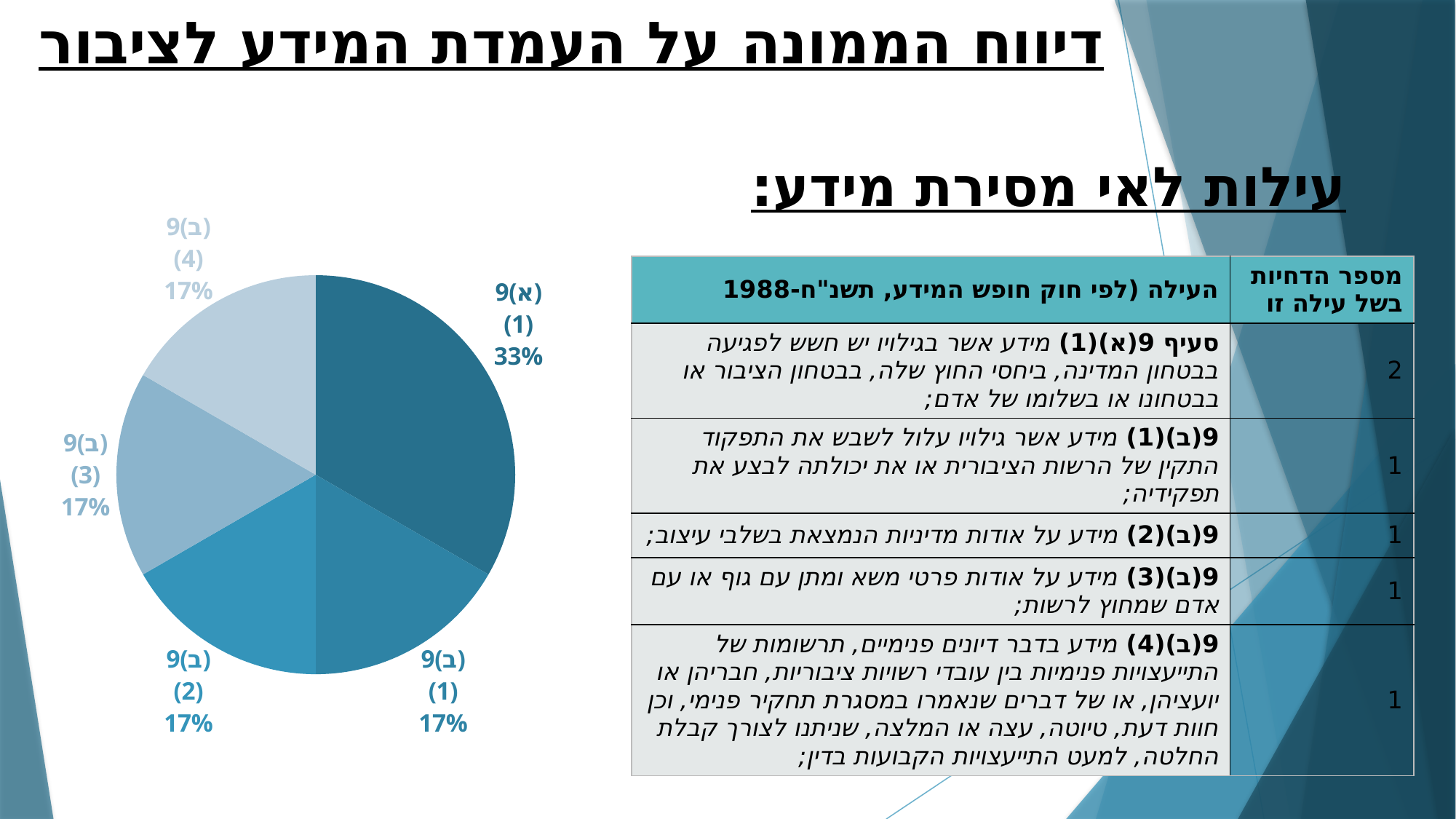
Is the share of the 9(א)(1) slice greater or less than 25%? greater How many slices in the pie chart are labelled 17%? 4 What share of the pie does the slice labelled 9(ב)(4) have? 17% What kind of chart is shown on the slide? pie chart What is the title of the section containing the pie chart? עילות לאי מסירת מידע Which slice of the pie chart is drawn in the darkest shade of blue? 9(א)(1) How many slices does the pie chart have? 5 What share of the pie does the slice labelled 9(ב)(2) have? 17% Which is larger in the pie chart, the slice for 9(א)(1) or the slice for 9(ב)(3)? 9(א)(1) Which slice of the pie chart is the largest? 9(א)(1) What is the difference in percentage points between the 9(א)(1) slice and the 9(ב)(1) slice? 16 What share of the pie does the slice labelled 9(א)(1) have? 33%